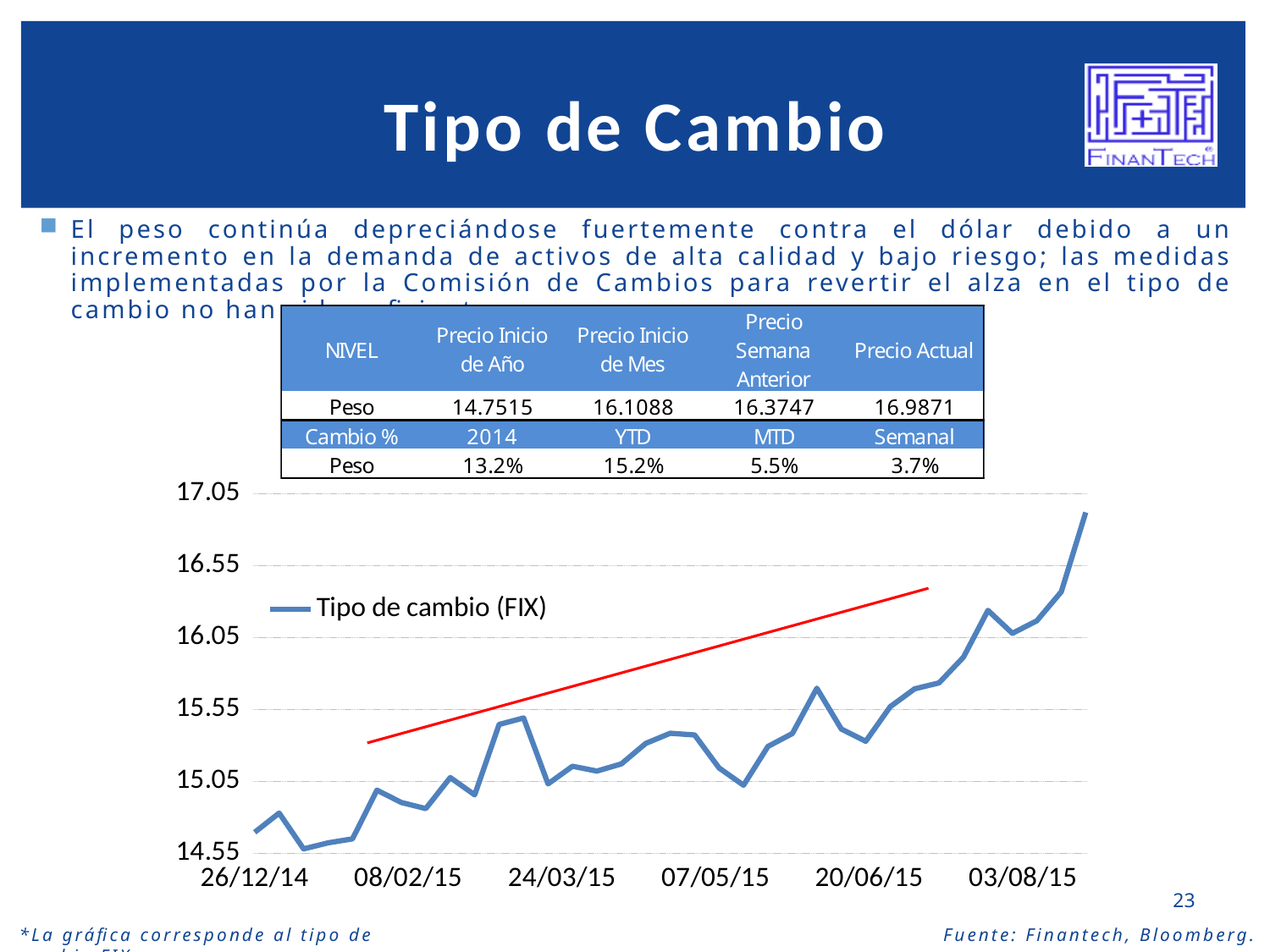
Which is larger, the value of Tipo de cambio (FIX) at 26/12/14 or at 03/08/15? 03/08/15 Is the value of Tipo de cambio (FIX) at 03/08/15 greater or less than 15.55? greater What is the name of the series shown in the chart legend? Tipo de cambio (FIX) How many series does the chart legend list? 1 Is the value of Tipo de cambio (FIX) at 26/12/14 greater or less than 15.05? less Overall, does the Tipo de cambio (FIX) line rise or fall from 26/12/14 to the end of the series? rise What kind of chart is shown on the slide? line chart Is the value of Tipo de cambio (FIX) at 07/05/15 greater or less than 15.05? greater How many date labels are shown on the x axis of the chart? 6 What is the highest value shown on the chart's y axis? 17.05